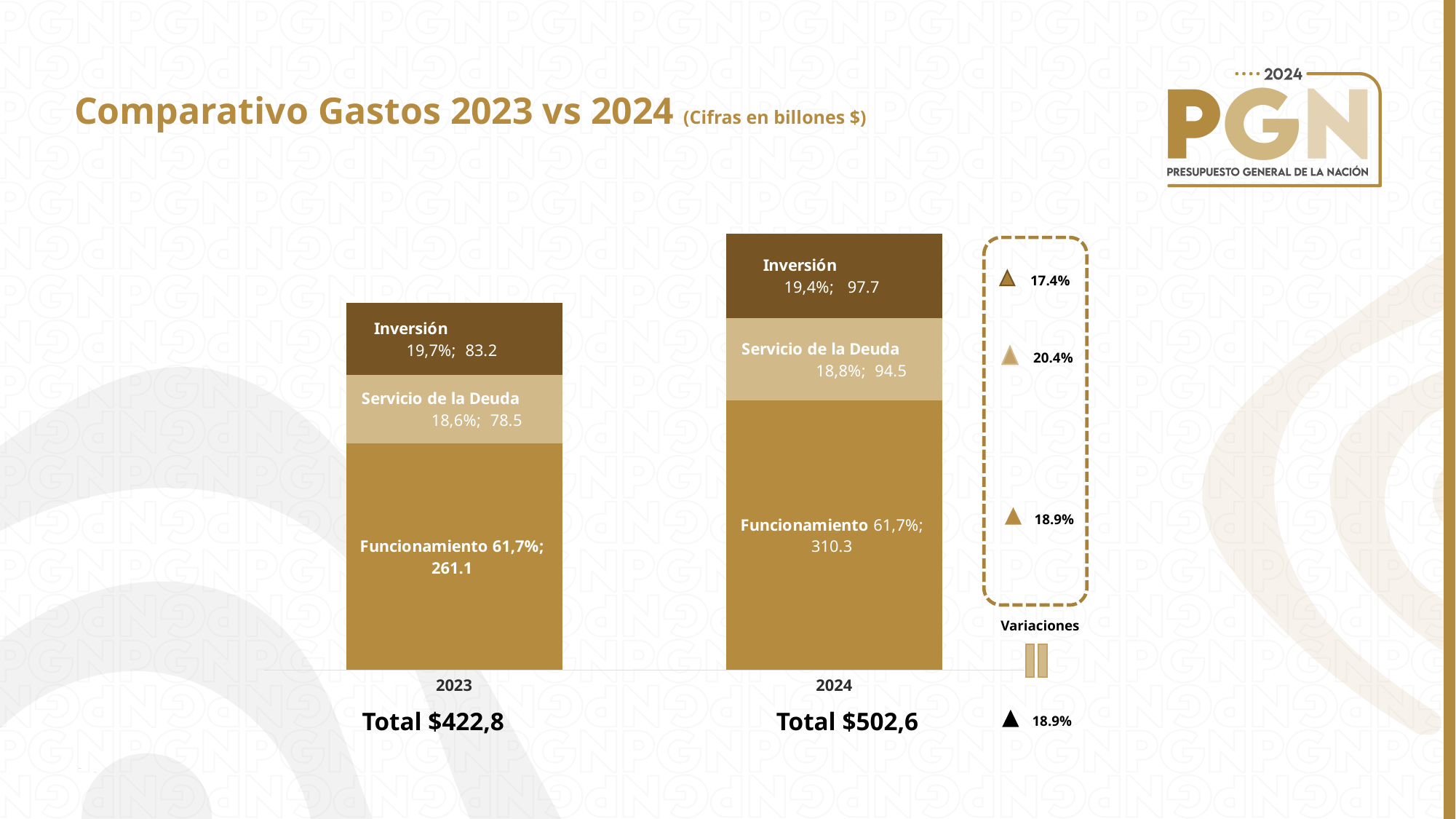
What is the total shown for 2024? $502,6 What variation percentage is shown for Servicio de la Deuda? 20.4% Which segment is the largest in the 2024 bar? Funcionamiento What is the value of Servicio de la Deuda for 2023? 78.5 What percentage share does Servicio de la Deuda have in 2024? 18,8% Which is larger, Inversión in 2023 or Inversión in 2024? Inversión in 2024 What is the total shown for 2023? $422,8 Which segment is the smallest in the 2023 bar? Servicio de la Deuda What is the value of Funcionamiento for 2023? 261.1 What kind of chart is shown on the slide? Stacked bar chart What is the value of Inversión for 2024? 97.7 What is the difference between Funcionamiento in 2024 and Funcionamiento in 2023? 49.2